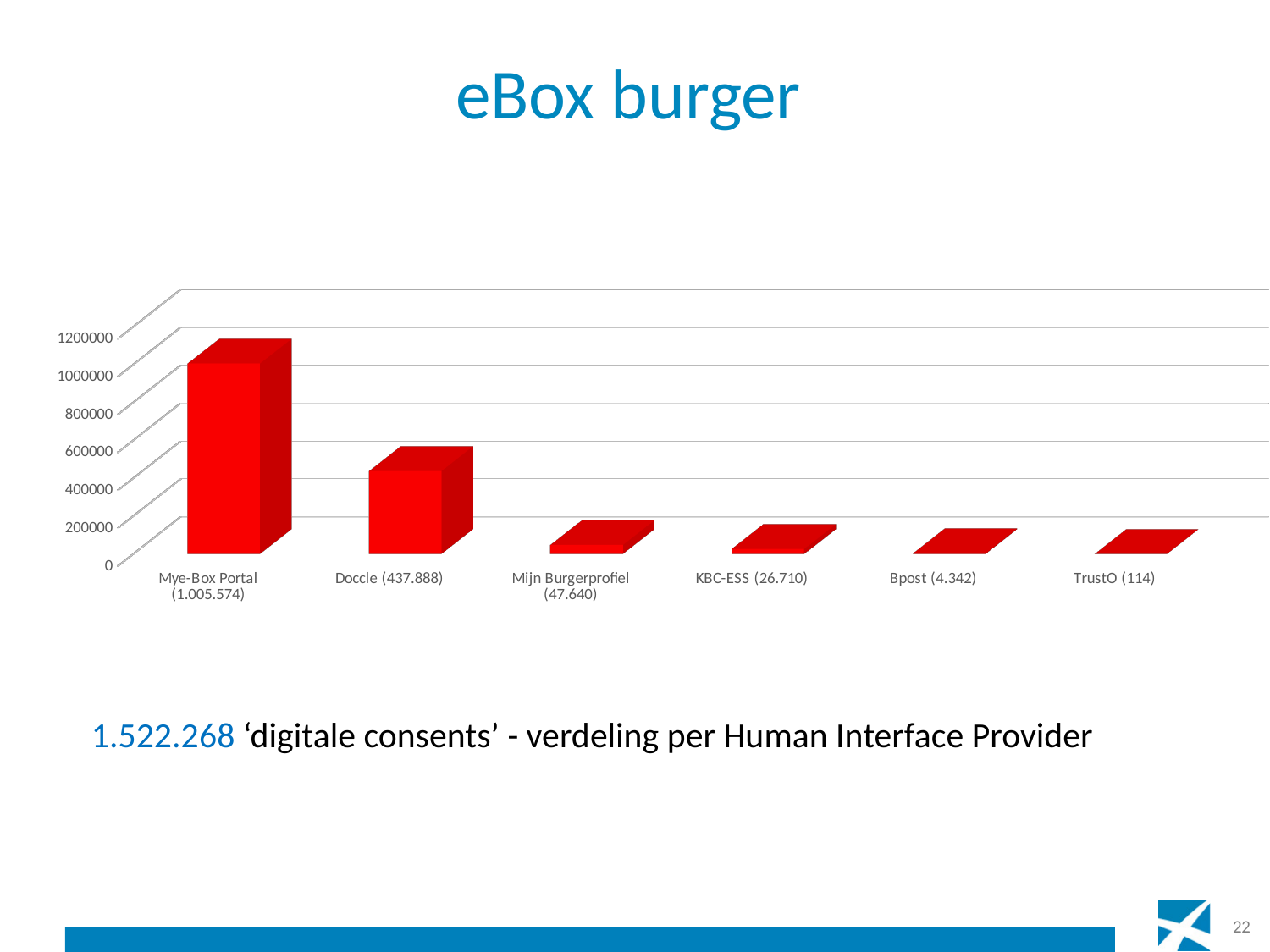
Which category has the lowest value? TrustO What kind of chart is shown on the slide? bar chart What is the difference between the values for Mijn Burgerprofiel and KBC-ESS? 20.930 Which category has the highest value? Mye-Box Portal What is the value for Doccle? 437.888 What is the difference between the values for Mye-Box Portal and Doccle? 567.686 What is the value for KBC-ESS? 26.710 What is the value for TrustO? 114 Is the value for Mye-Box Portal greater or less than 800000? greater What is the value for Mijn Burgerprofiel? 47.640 How many categories are shown on the x axis? 6 Which is larger, the value for Bpost or the value for KBC-ESS? KBC-ESS